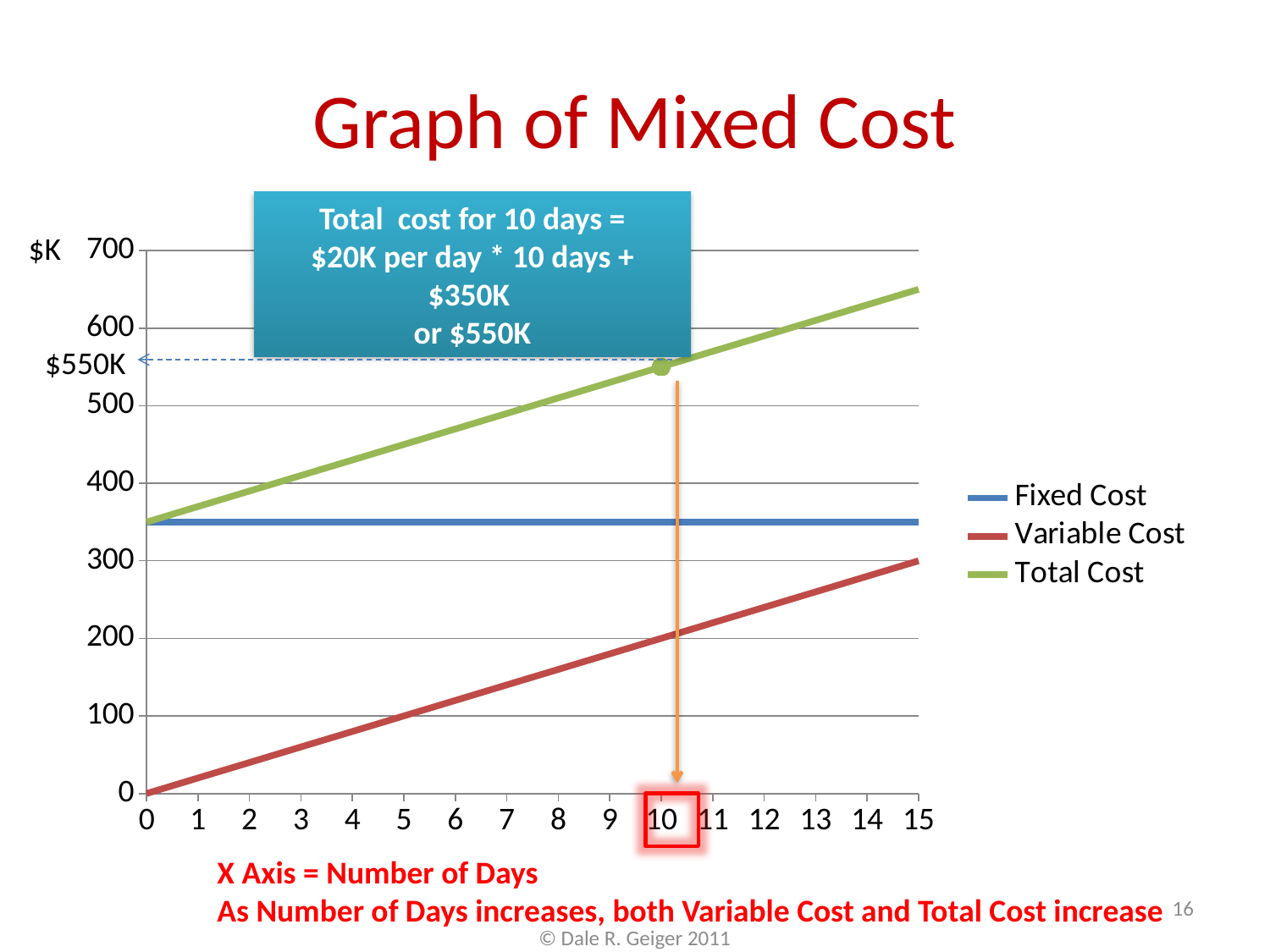
What kind of chart is shown on the slide? line chart Which series is lowest at 5 days? Variable Cost What is the Fixed Cost shown on the chart? $350K Is the Variable Cost at 5 days greater or less than 200? less What is the Variable Cost at 15 days? 300 How many series does the legend list? 3 Is the Total Cost at 15 days greater or less than 600? greater What is the Variable Cost at 0 days? 0 Which series is highest at 15 days? Total Cost What is the title of the chart? Graph of Mixed Cost Does the Total Cost rise or fall as the number of days increases? rise What is the Total Cost at 10 days? $550K